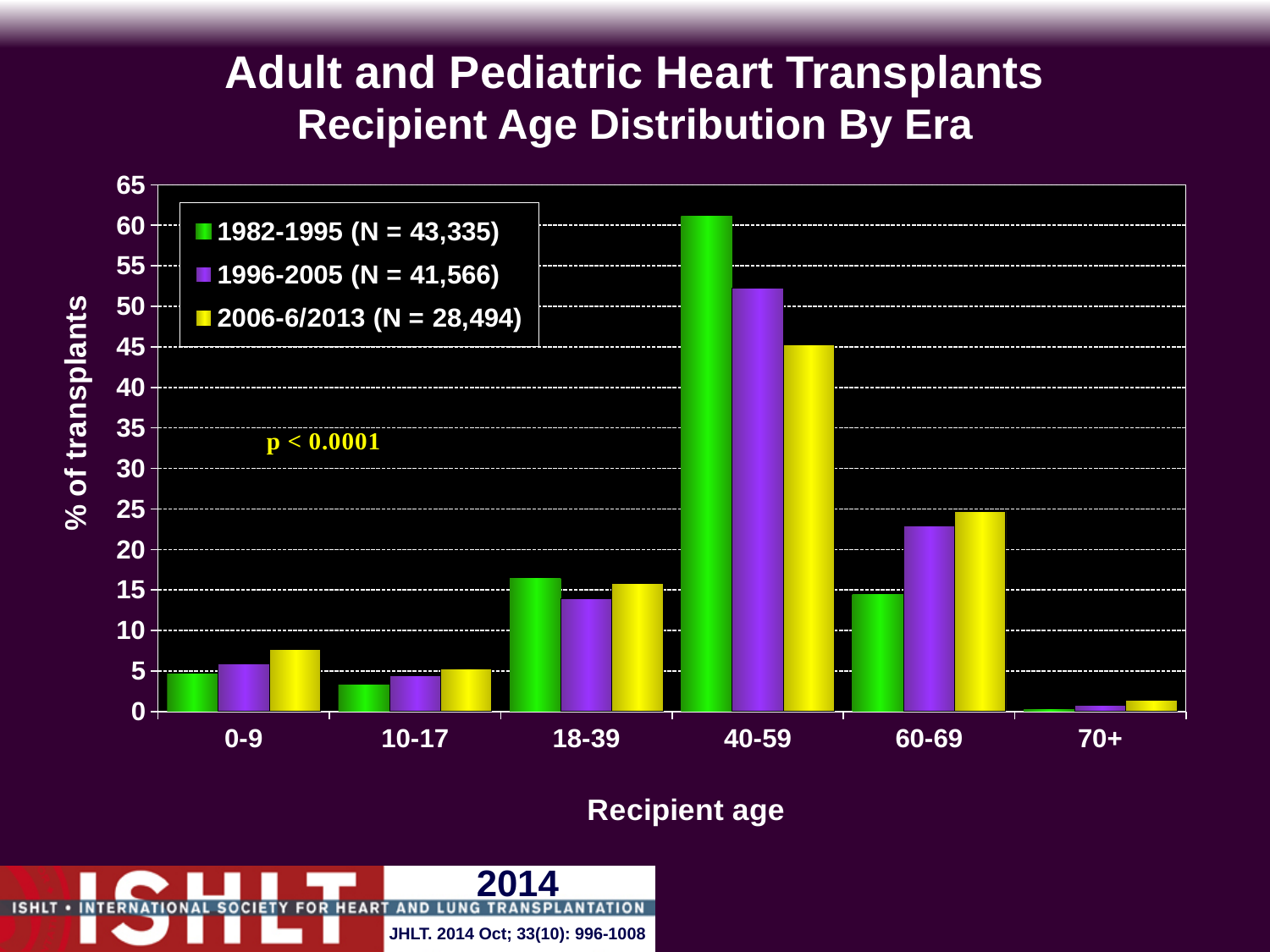
How many recipient age categories are shown on the x axis? 6 For the 1982-1995 era, which recipient age group has the lowest percentage of transplants? 70+ Is the value for 2006-6/2013 in the 40-59 age group greater or less than 50? less Is the value for 1982-1995 in the 40-59 age group greater or less than 55? greater In the 60-69 age group, which era has the larger value: 1982-1995 or 2006-6/2013? 2006-6/2013 Across the three eras in order, does the percentage for the 40-59 age group rise or fall? fall What p-value is printed on the chart? p < 0.0001 In the 40-59 age group, which era has the larger value: 1982-1995 or 1996-2005? 1982-1995 How many series does the legend list? 3 What kind of chart is shown on the slide? bar chart For the 1982-1995 era, which recipient age group has the highest percentage of transplants? 40-59 Is the value for 1996-2005 in the 60-69 age group greater or less than 20? greater